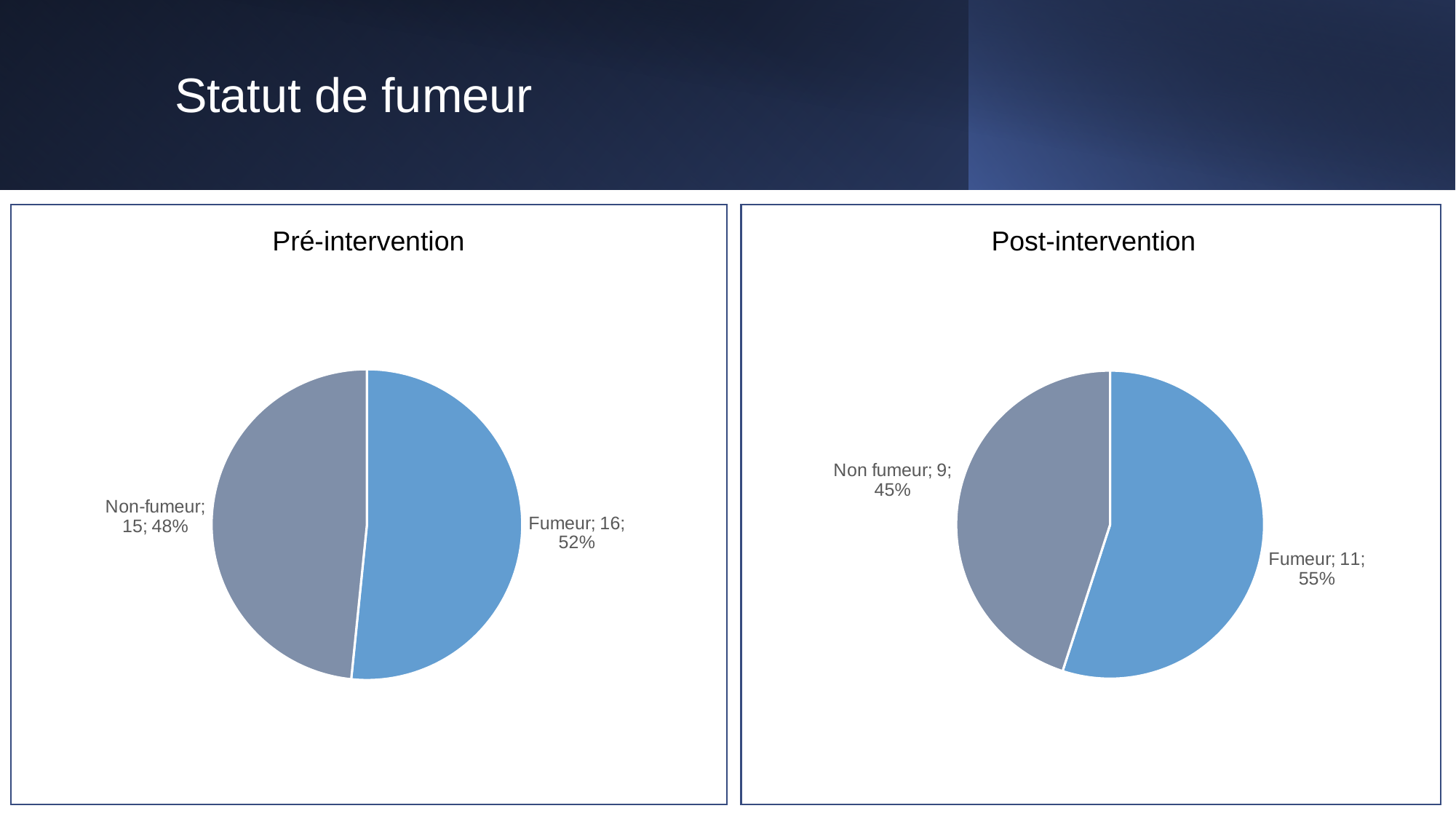
In the Post-intervention chart, what is the value for Non fumeur? 9 What kind of chart is the Post-intervention chart? Pie chart In the Pré-intervention chart, which category is the smallest? Non-fumeur In the Post-intervention chart, which category is the largest? Fumeur In the Post-intervention chart, what is the difference between the Fumeur and Non fumeur values? 2 In the Post-intervention chart, what is the value for Fumeur? 11 In the Pré-intervention chart, what is the value for Fumeur? 16 How many categories does the Pré-intervention chart show? 2 In the Pré-intervention chart, what share of the pie does Fumeur represent? 52% In the Pré-intervention chart, what is the total of all slices? 31 In the Pré-intervention chart, what is the value for Non-fumeur? 15 In the Post-intervention chart, what share of the pie does Non fumeur represent? 45%